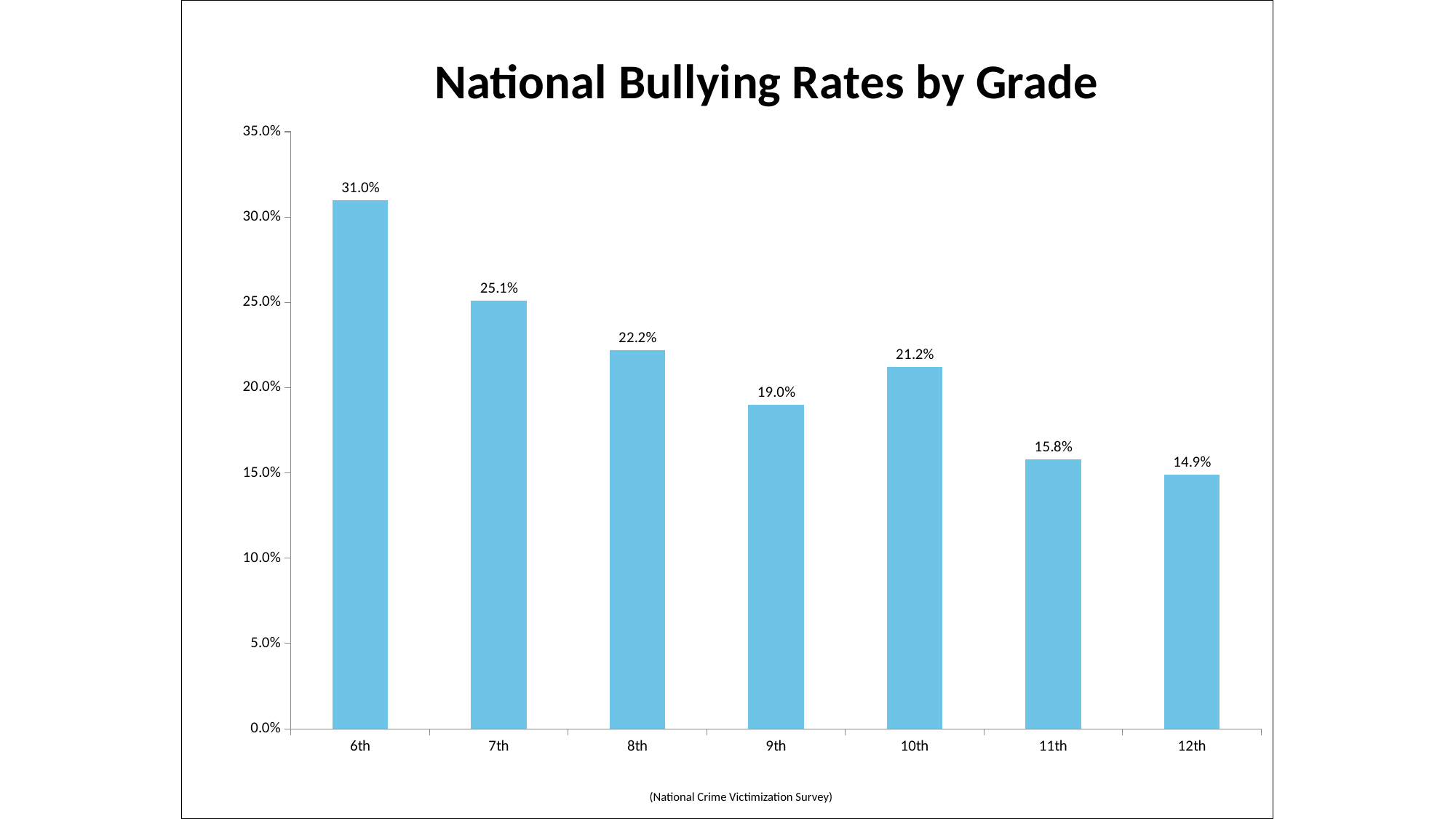
What is the difference between the bullying rates for 6th grade and 7th grade? 5.9% Which grade has the highest bullying rate? 6th Is the value for 11th grade greater or less than 20.0%? less What is the bullying rate for 6th grade? 31.0% What kind of chart is shown on the slide? Bar chart Which grade has the lowest bullying rate? 12th What is the bullying rate for 12th grade? 14.9% Which has a higher bullying rate, 9th grade or 10th grade? 10th What is the title of the chart? National Bullying Rates by Grade How many grades are shown on the chart? 7 What is the bullying rate for 9th grade? 19.0% What is the difference between the bullying rates for 8th grade and 10th grade? 1.0%